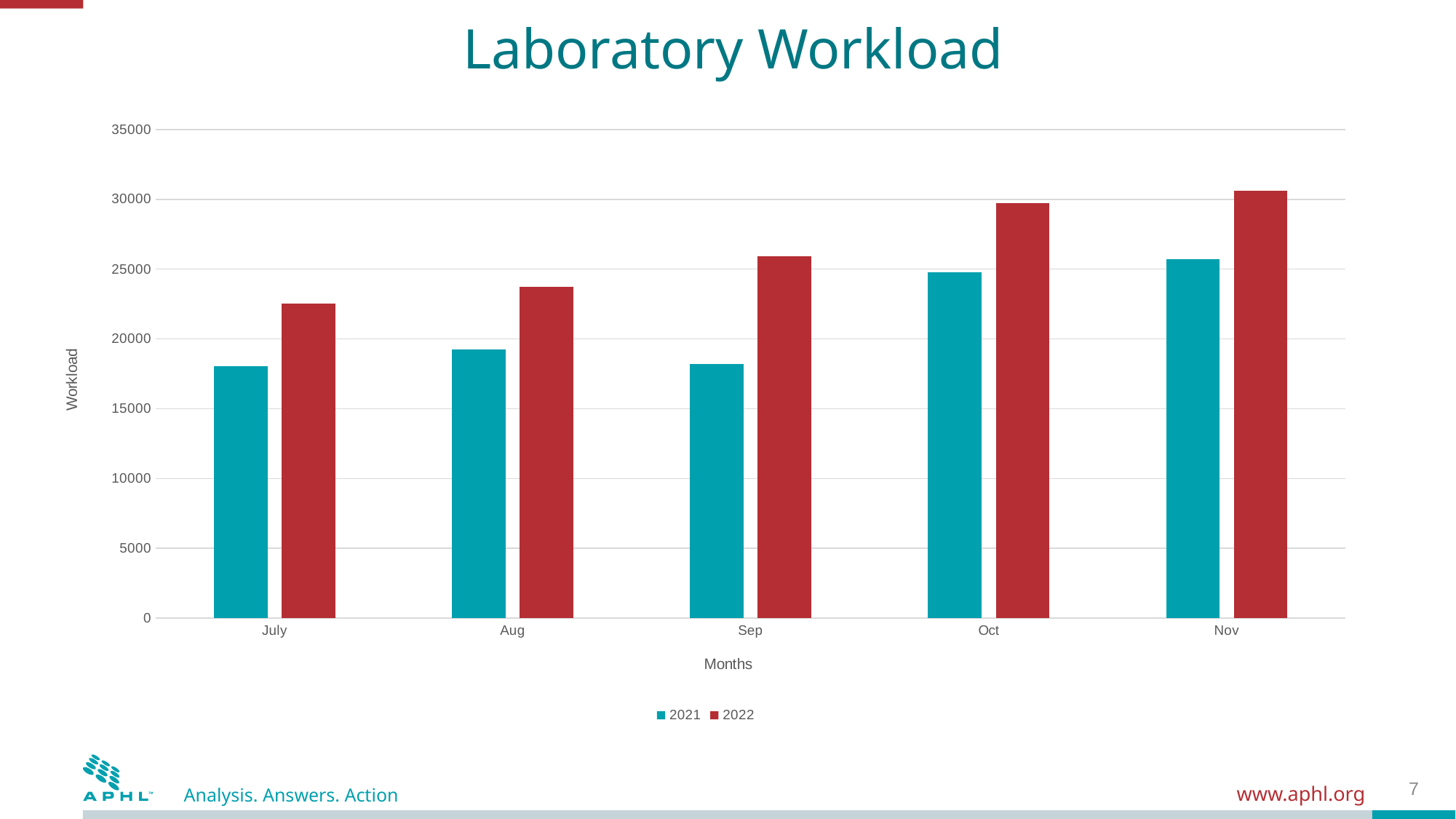
Which month has the highest 2022 workload? Nov Is the 2021 value for July greater or less than 20000? less Is the 2022 value for Nov greater or less than 30000? greater How many series does the legend list? 2 Which month has the highest 2021 workload? Nov Which month has the lowest 2022 workload? July Which is larger in Oct, the 2021 value or the 2022 value? 2022 What kind of chart is shown on the slide? bar chart Do the 2022 values rise or fall from July to Nov? rise Is the 2022 value for Sep greater or less than 25000? greater How many months are shown on the x axis? 5